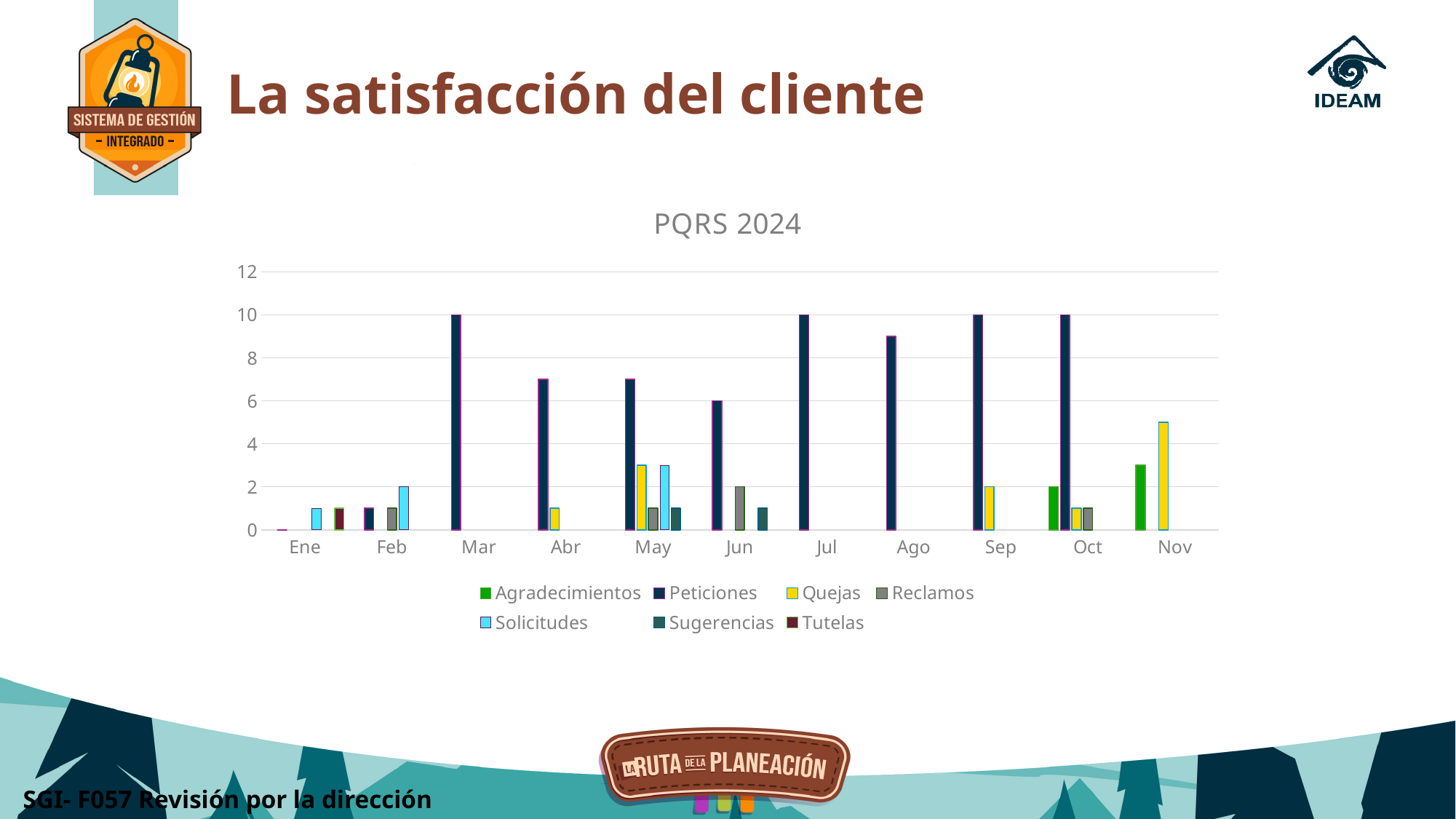
Is the value for Peticiones in Abr greater or less than 8? less How many series does the legend list? 7 What is the title of the chart? PQRS 2024 Which series has the highest value in Sep? Peticiones What is the value of Peticiones in Mar? 10 How many months are shown on the x axis? 11 Which is larger, Peticiones in Jun or Peticiones in Ago? Peticiones in Ago Is the value for Peticiones in Ago greater or less than 8? greater What is the value of Solicitudes in Feb? 2 What kind of chart is shown on the slide? bar chart What is the difference between Peticiones in Mar and Peticiones in Jun? 4 What is the value of Peticiones in Jun? 6